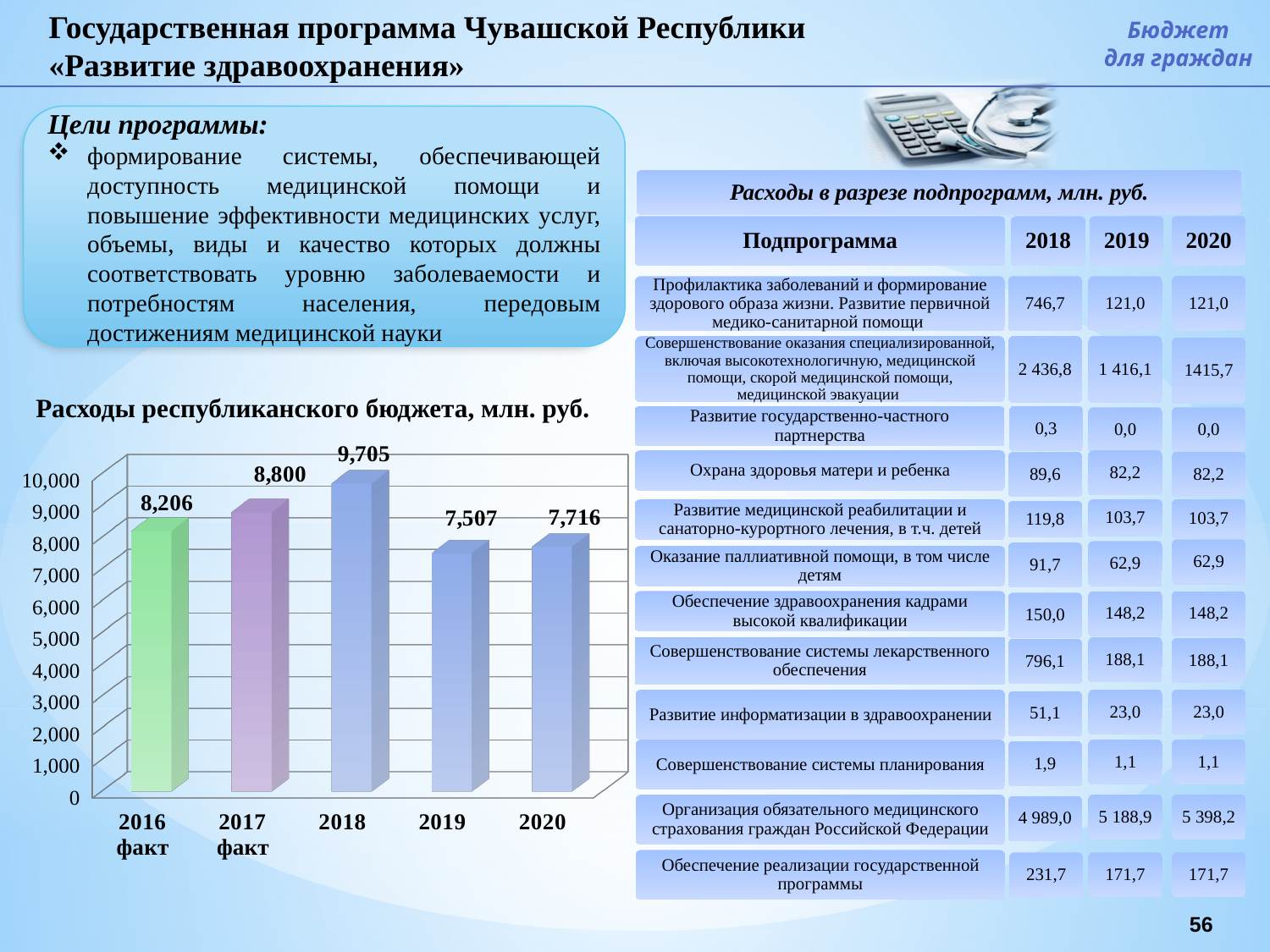
How many years are shown on the x axis of the chart "Расходы республиканского бюджета, млн. руб."? 5 In the chart "Расходы республиканского бюджета, млн. руб.", is the value for 2019 greater or less than 8,000? less What kind of chart is "Расходы республиканского бюджета, млн. руб."? bar chart In the chart "Расходы республиканского бюджета, млн. руб.", what is the difference between the values for 2018 and 2016 факт? 1,499 Which year has the lowest value in the chart "Расходы республиканского бюджета, млн. руб."? 2019 What is the value for 2016 факт in the chart "Расходы республиканского бюджета, млн. руб."? 8,206 What is the value for 2020 in the chart "Расходы республиканского бюджета, млн. руб."? 7,716 In the chart "Расходы республиканского бюджета, млн. руб.", what is the difference between the values for 2020 and 2019? 209 In the chart "Расходы республиканского бюджета, млн. руб.", which is larger: the value for 2017 факт or the value for 2020? 2017 факт What is the value for 2018 in the chart "Расходы республиканского бюджета, млн. руб."? 9,705 Which year has the highest value in the chart "Расходы республиканского бюджета, млн. руб."? 2018 In the chart "Расходы республиканского бюджета, млн. руб.", do the values rise or fall from 2018 to 2019? fall